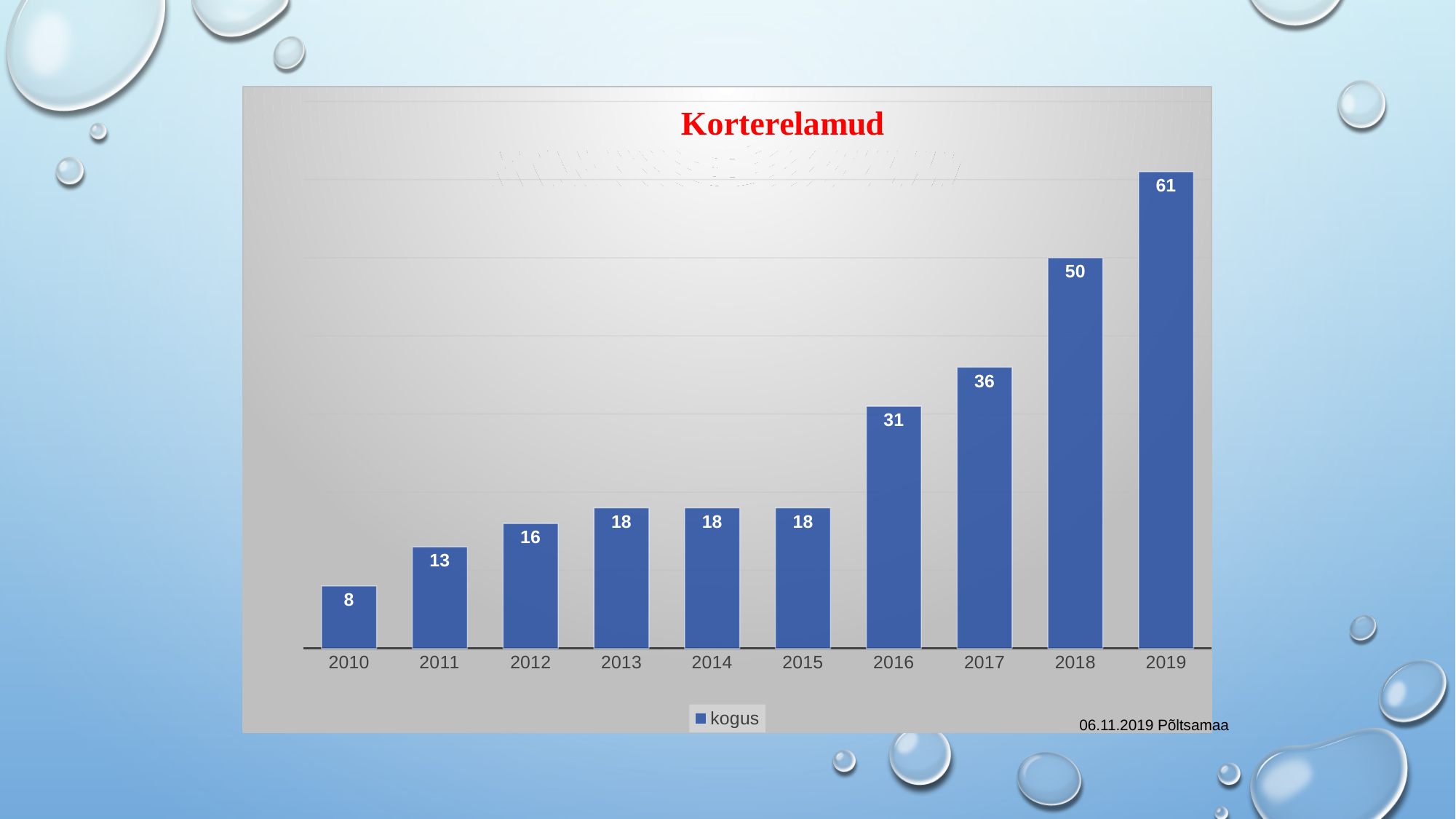
How many years are shown on the x axis of the chart? 10 What is the title of the chart? Korterelamud Which year has the highest value in the Korterelamud chart? 2019 What is the value for 2018 in the Korterelamud chart? 50 What is the value for 2016 in the Korterelamud chart? 31 Which year has the lowest value in the Korterelamud chart? 2010 How many series does the legend list? 1 What is the difference between the values for 2017 and 2012? 20 What is the value for 2010 in the Korterelamud chart? 8 What is the difference between the values for 2019 and 2018? 11 What kind of chart is shown on the slide? bar chart Which is larger, the value for 2011 or the value for 2016? 2016